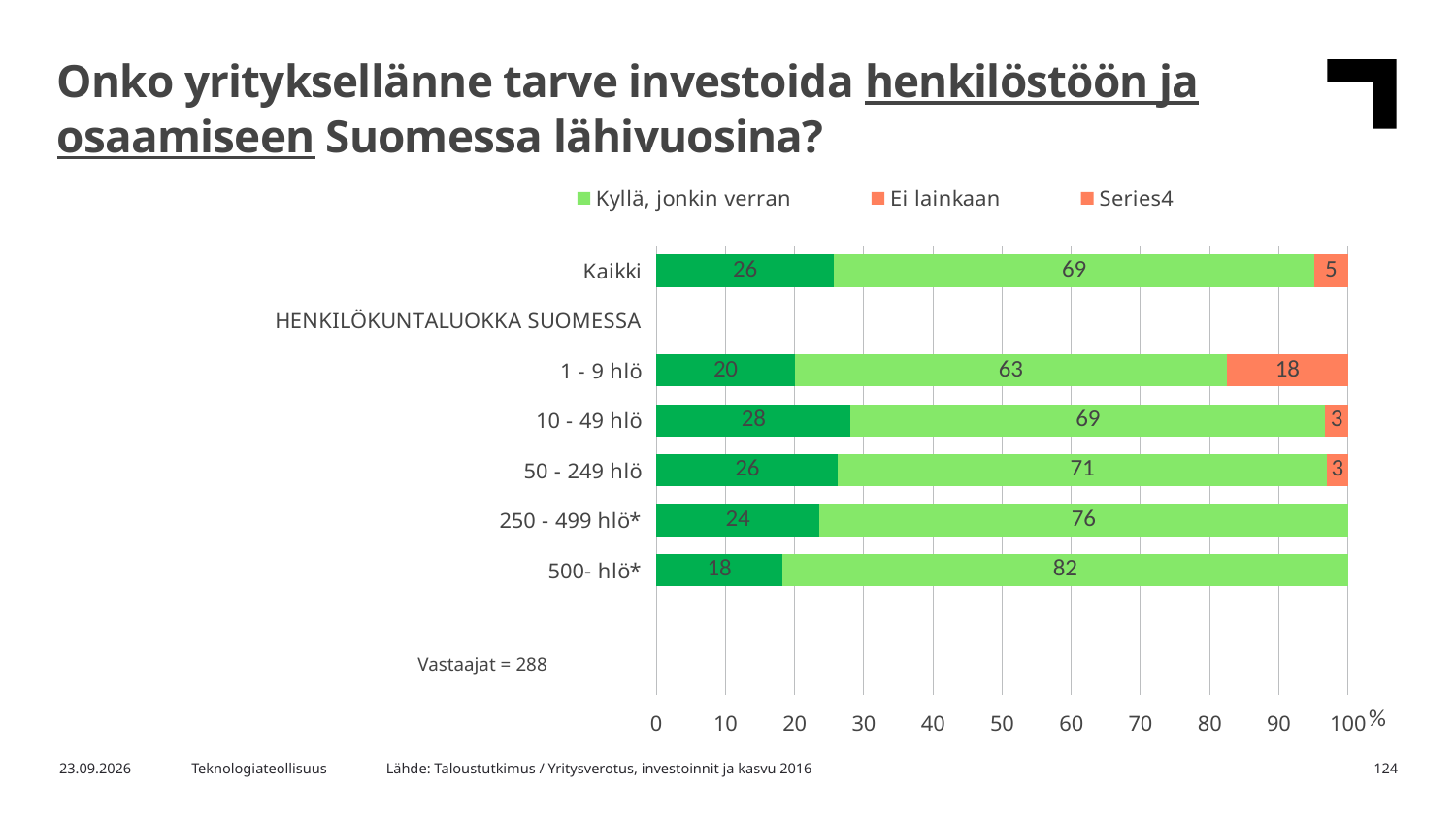
What is the value of the orange 'Ei lainkaan' segment for '1 - 9 hlö'? 18 What is the total of the three labelled segments in the 'Kaikki' bar? 100 Which has the larger dark green (first) segment: '10 - 49 hlö' or '50 - 249 hlö'? 10 - 49 hlö Which category has the largest 'Kyllä, jonkin verran' segment? 500- hlö* What kind of chart is shown on the slide? Stacked bar chart What is the difference between the 'Kyllä, jonkin verran' values for '500- hlö*' and '1 - 9 hlö'? 19 How many series does the legend list? 3 What is the value of the 'Kyllä, jonkin verran' segment for '500- hlö*'? 82 Which category has the smallest dark green (first) segment? 500- hlö* How many categories have bars plotted in the chart? 6 Which category has the largest orange 'Ei lainkaan' segment? 1 - 9 hlö What is the value of the 'Kyllä, jonkin verran' segment for 'Kaikki'? 69